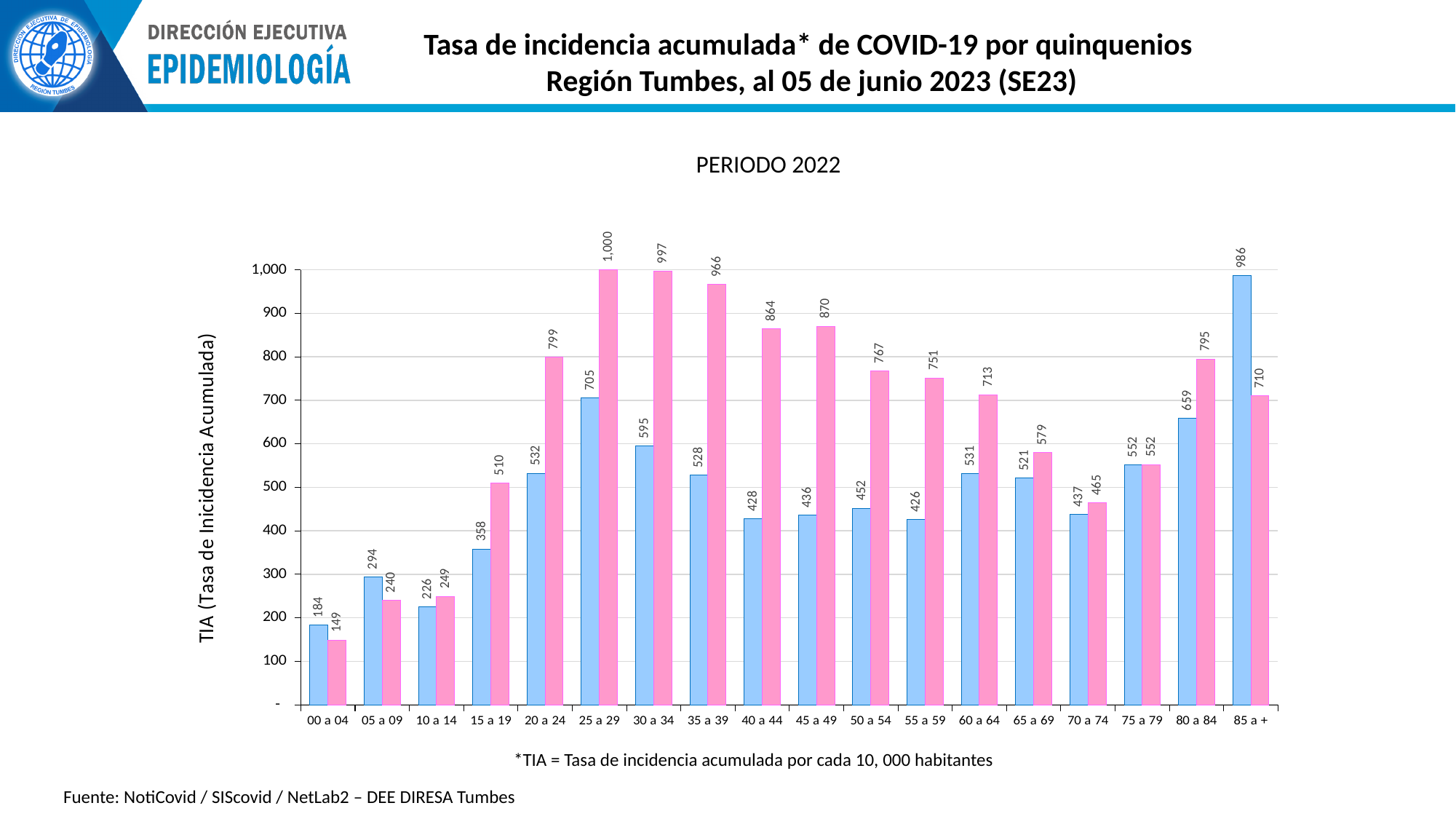
What is the difference between the pink and blue bars for the 20 a 24 age group? 267 How many age groups are shown on the x axis? 18 Which age group has the highest pink bar? 25 a 29 What is the value of the blue bar for the 40 a 44 age group? 428 What is the subtitle shown above the chart? PERIODO 2022 What is the value of the pink bar for the 25 a 29 age group? 1,000 Which age group has the highest blue bar? 85 a + What is the value of the blue bar for the 85 a + age group? 986 What is the y-axis label of the chart? TIA (Tasa de Incidencia Acumulada) Which age group has the lowest blue bar? 00 a 04 What type of chart is shown on the slide? bar chart Which is larger for the 85 a + age group, the blue bar or the pink bar? the blue bar